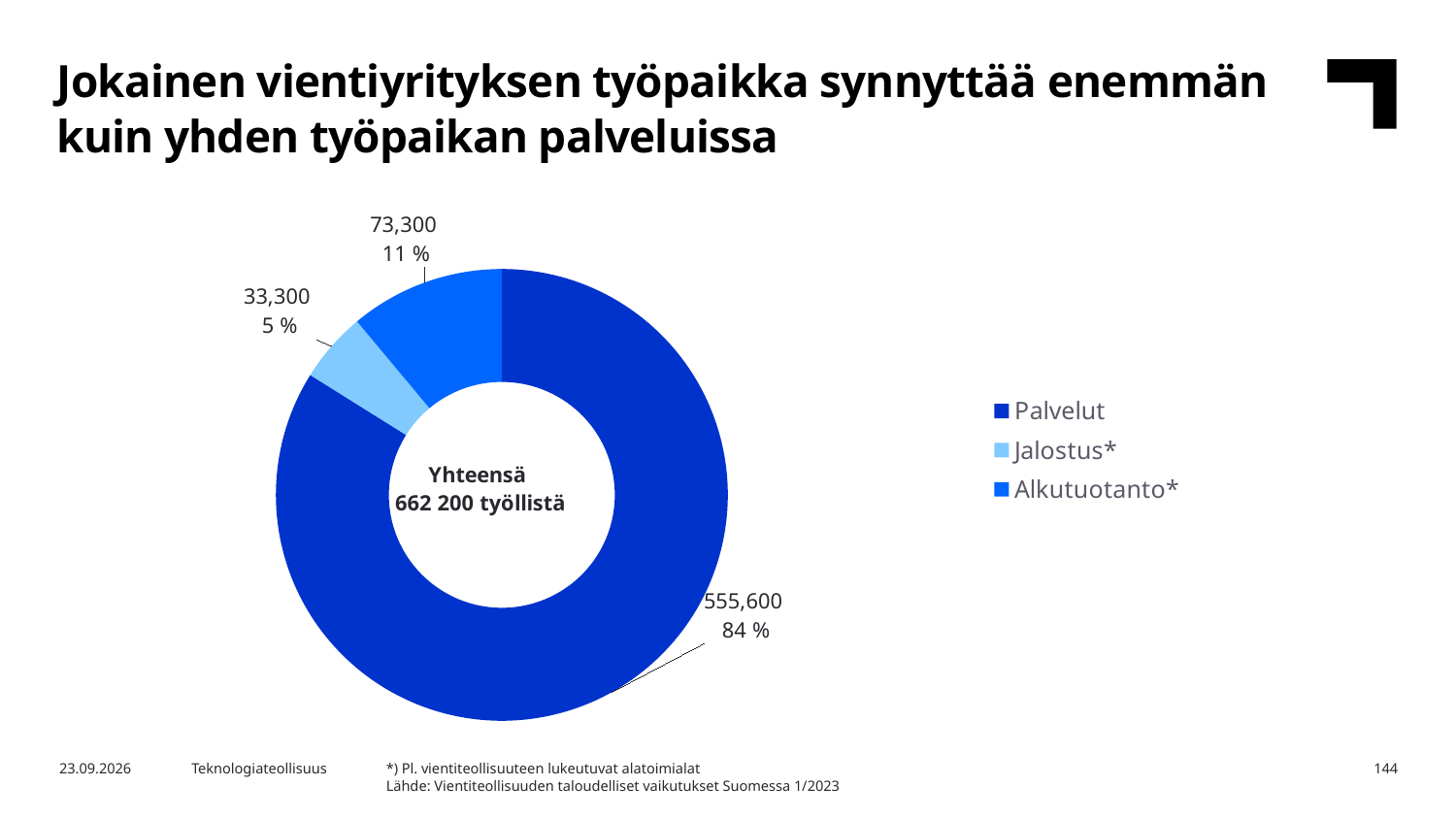
Which category has the largest slice? Palvelut What kind of chart is shown on the slide? Pie chart (donut) How many categories does the legend list? 3 What share of the pie does Jalostus* represent? 5 % What is the difference between the values for Alkutuotanto* and Jalostus*? 40,000 What is the value shown for Alkutuotanto*? 73,300 What is the value shown for Palvelut? 555,600 What total is printed in the centre of the donut chart? 662 200 työllistä Which is larger, the value for Alkutuotanto* or the value for Jalostus*? Alkutuotanto* What is the value shown for Jalostus*? 33,300 Which category has the smallest slice? Jalostus* What share of the pie does Palvelut represent? 84 %